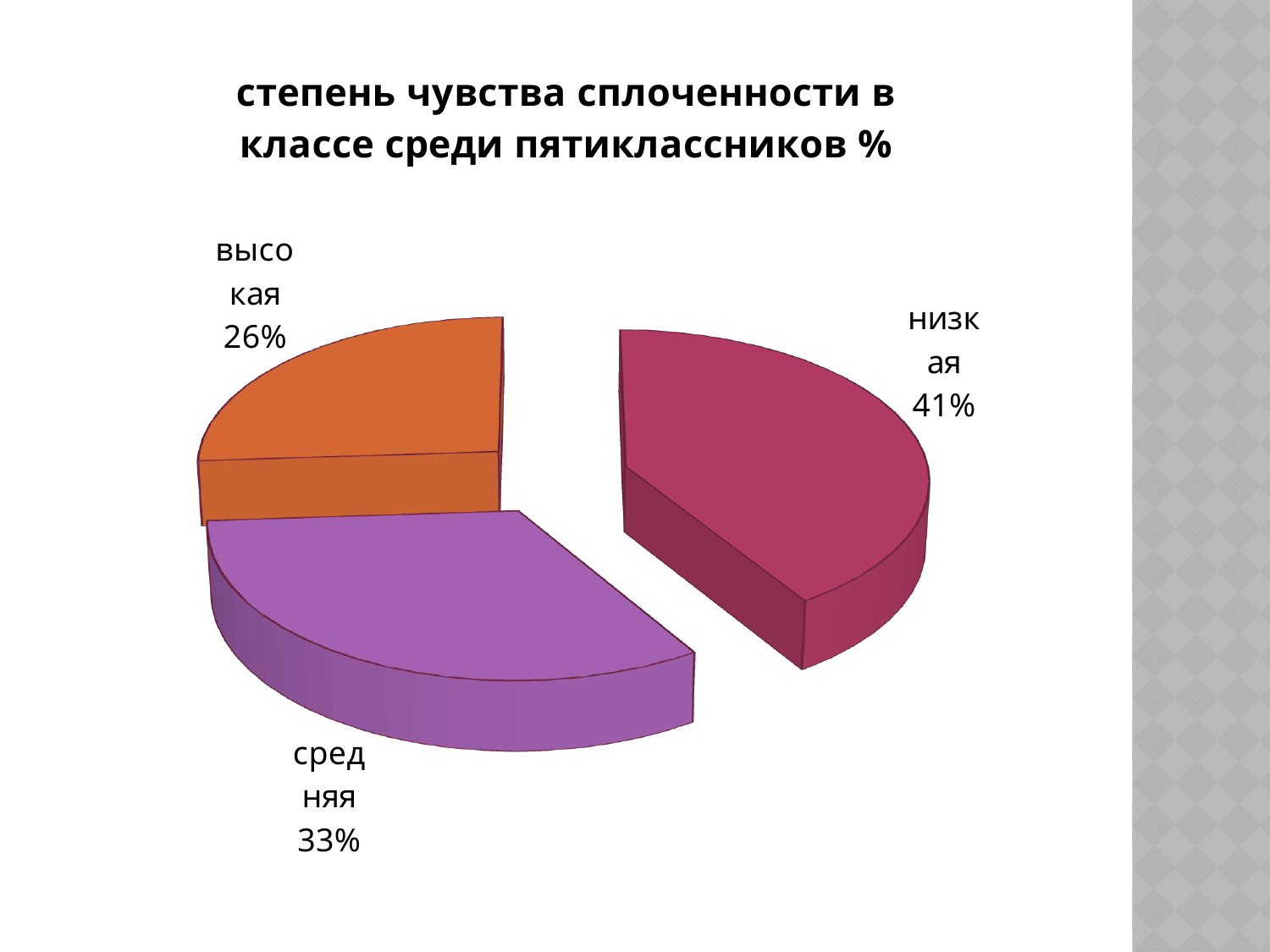
How many slices does the pie chart have? 3 Which category has the largest share of the pie? низкая What is the difference in percentage points between 'средняя' and 'высокая'? 7 What percentage is shown for the 'высокая' slice? 26% What is the title of the chart? степень чувства сплоченности в классе среди пятиклассников % What type of chart is shown on the slide? pie chart What colour is the 'средняя' slice? purple What percentage is shown for the 'средняя' slice? 33% Which category has the smallest share of the pie? высокая What percentage is shown for the 'низкая' slice? 41% What is the difference in percentage points between 'низкая' and 'высокая'? 15 Which is larger, the share for 'средняя' or the share for 'высокая'? средняя